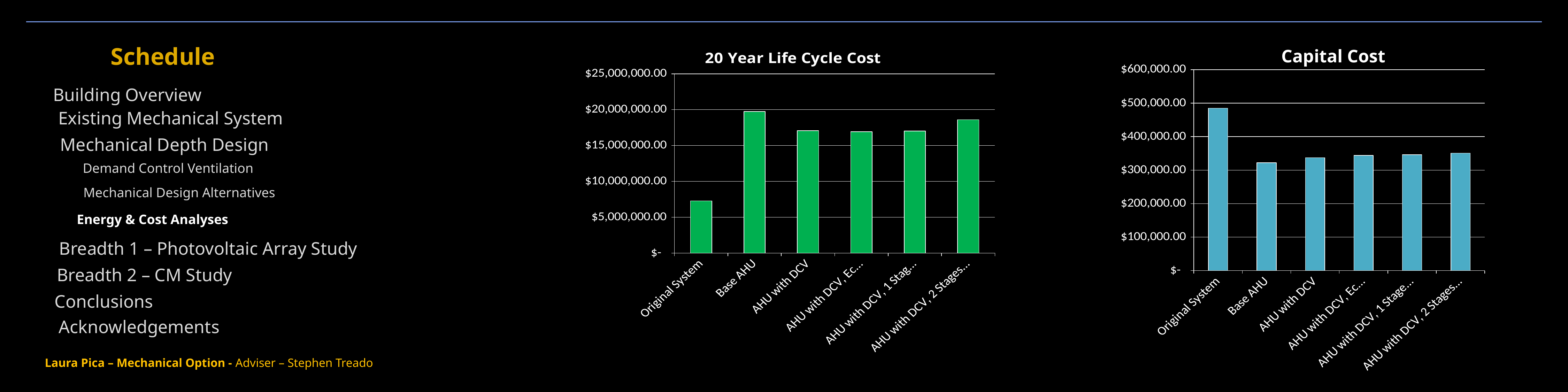
In the "20 Year Life Cycle Cost" chart, is the value for Original System greater or less than $10,000,000.00? less In the "Capital Cost" chart, is the value for Base AHU greater or less than $400,000.00? less In the "Capital Cost" chart, which is larger, the value for Original System or the value for AHU with DCV? Original System In the "20 Year Life Cycle Cost" chart, which is larger, the value for Base AHU or the value for AHU with DCV? Base AHU In the "20 Year Life Cycle Cost" chart, which category has the highest value? Base AHU In the "20 Year Life Cycle Cost" chart, is the value for Base AHU greater or less than $15,000,000.00? greater What is the title of the chart on the right side of the slide? Capital Cost In the "Capital Cost" chart, which category has the highest value? Original System In the "20 Year Life Cycle Cost" chart, which category has the lowest value? Original System What kind of chart is the "20 Year Life Cycle Cost" chart? bar chart How many categories are shown in the "20 Year Life Cycle Cost" chart? 6